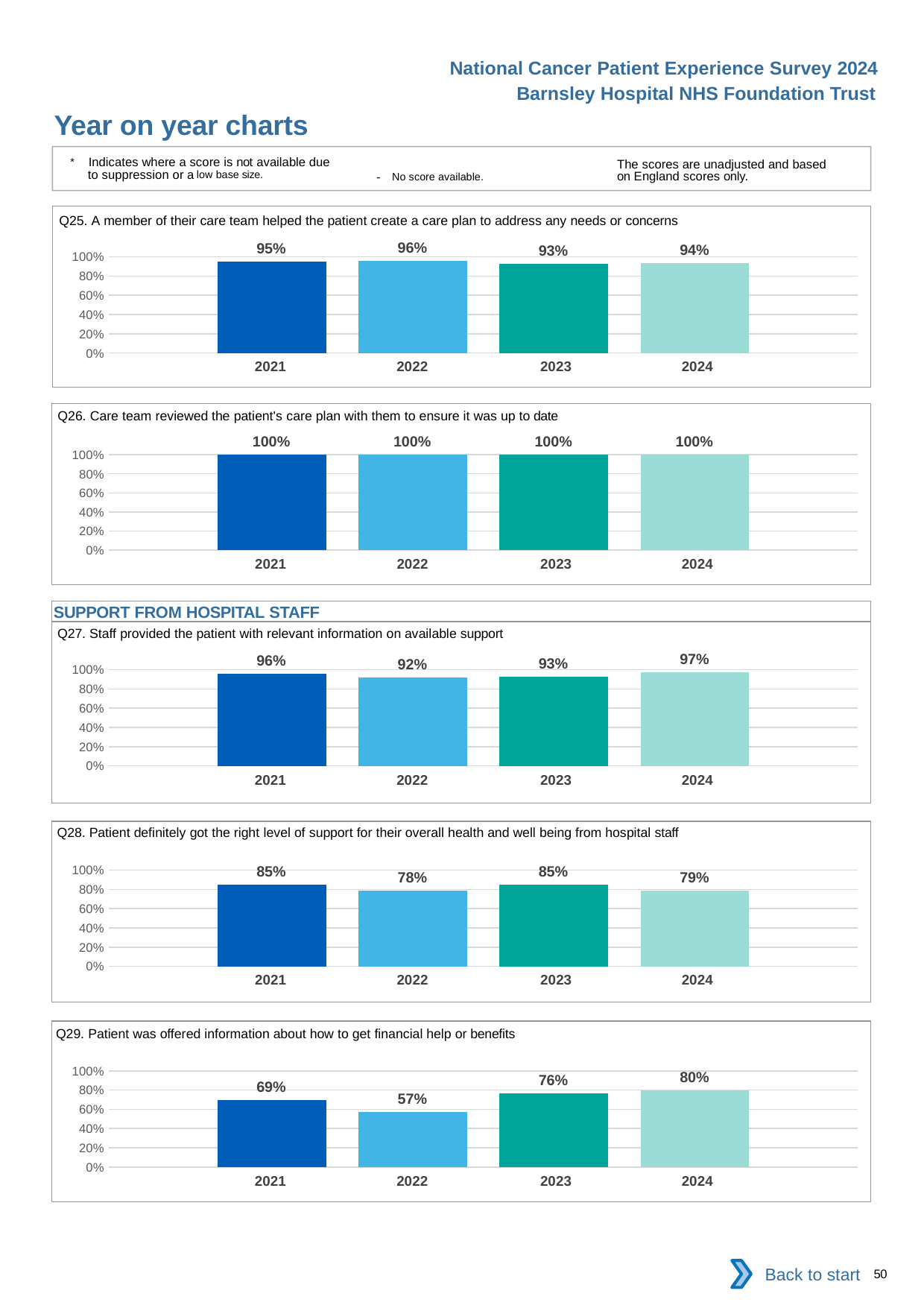
In the Q27 chart, which year has the highest value? 2024 In the Q25 chart, what is the value for 2022? 96% In the Q28 chart, what is the value for 2022? 78% In the Q26 chart, what is the value for 2024? 100% In the Q29 chart, what is the difference between the 2024 value and the 2021 value? 11% In the Q29 chart, do the values rise or fall from 2022 to 2024? rise In the Q27 chart, what is the difference between the 2024 value and the 2022 value? 5% In the Q25 chart, which year has the lowest value? 2023 What kind of chart is the Q29 chart? bar chart How many years are shown on the x axis of the Q28 chart? 4 In the Q28 chart, which is larger, the value for 2021 or the value for 2024? 2021 In the Q29 chart, which year has the lowest value? 2022